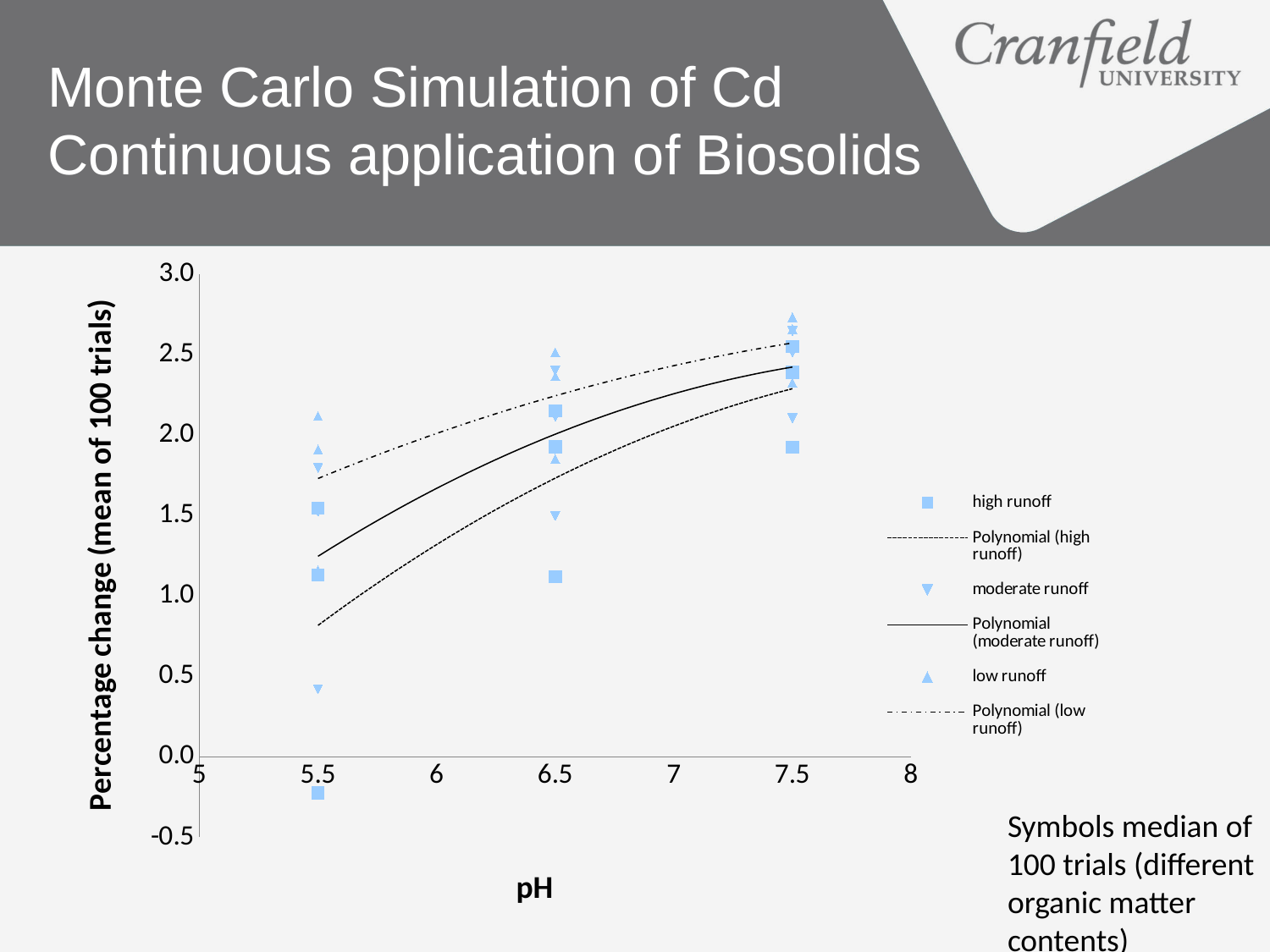
Is the lowest high runoff symbol at pH 6.5 greater or less than 1.0? greater What kind of chart is shown on the slide? scatter chart Is the lowest high runoff symbol at pH 5.5 greater or less than 0.0? less At how many distinct pH values are the symbols plotted? 3 How many entries does the chart legend list? 6 Do the polynomial trend lines rise or fall as pH increases? rise What is the title of the y axis of the chart? Percentage change (mean of 100 trials) Is the highest low runoff symbol at pH 7.5 greater or less than 2.5? greater What is the title of the x axis of the chart? pH Which polynomial trend line lies highest on the chart? Polynomial (low runoff) Which polynomial trend line lies lowest on the chart? Polynomial (high runoff)